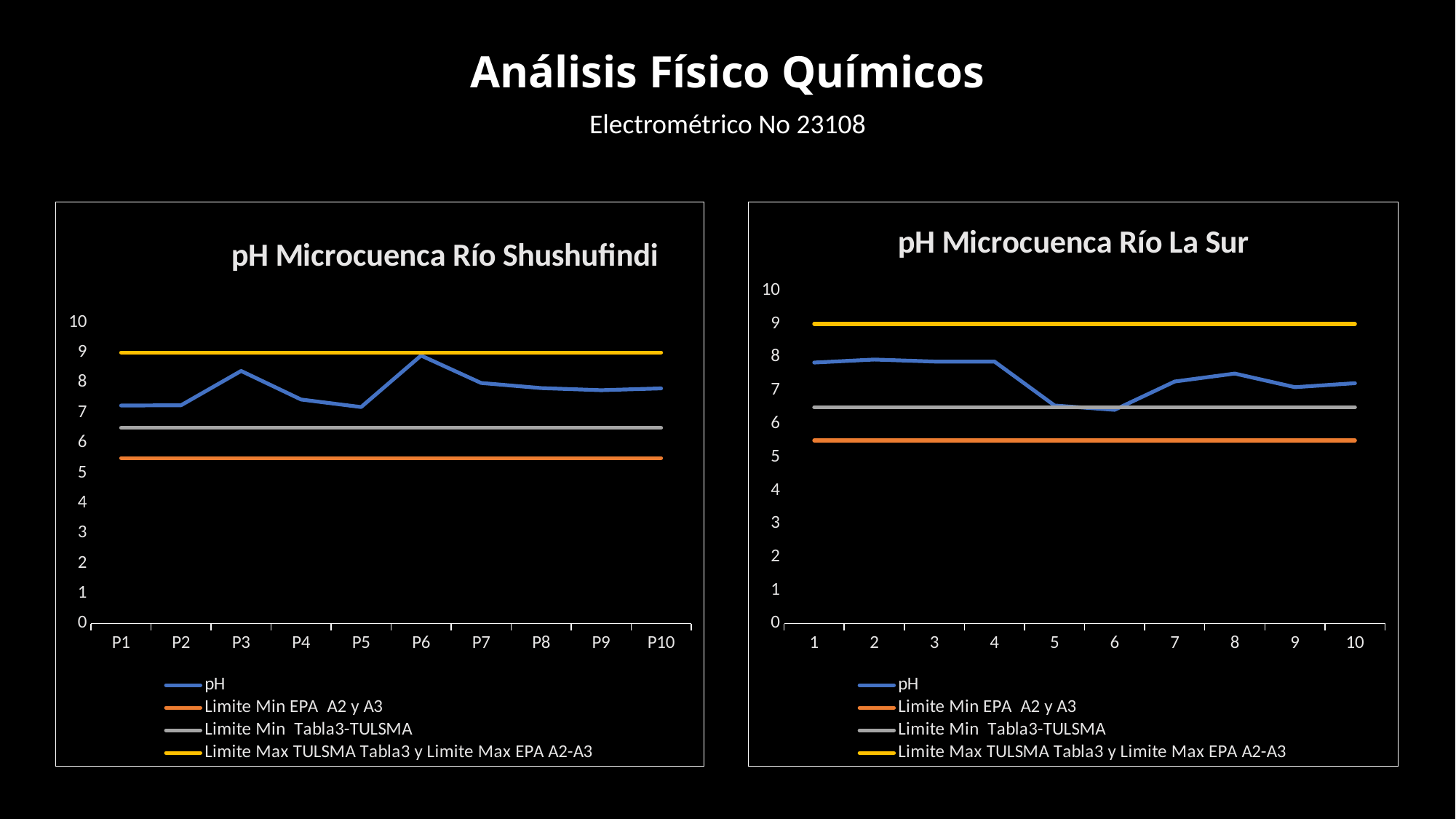
In the chart titled 'pH Microcuenca Río La Sur', is the pH value at point 1 greater or less than 7? greater In the chart titled 'pH Microcuenca Río La Sur', which has the higher pH value, point 4 or point 5? 4 What kind of chart is the chart titled 'pH Microcuenca Río Shushufindi'? line chart In the chart titled 'pH Microcuenca Río Shushufindi', is the pH value at P6 greater or less than 8? greater In the chart titled 'pH Microcuenca Río Shushufindi', which has the higher pH value, P3 or P4? P3 In the chart titled 'pH Microcuenca Río La Sur', at which point does the pH series reach its lowest value? 6 In the chart titled 'pH Microcuenca Río Shushufindi', at which point does the pH series reach its highest value? P6 In the chart titled 'pH Microcuenca Río La Sur', does the pH series rise or fall from point 6 to point 8? rise How many series does the legend of the chart titled 'pH Microcuenca Río La Sur' list? 4 In the chart titled 'pH Microcuenca Río La Sur', is the pH value at point 6 greater or less than 7? less In the chart titled 'pH Microcuenca Río Shushufindi', which legend entry is drawn as the yellow line? Limite Max TULSMA Tabla3 y Limite Max EPA A2-A3 How many points are plotted along the x axis of the chart titled 'pH Microcuenca Río Shushufindi'? 10